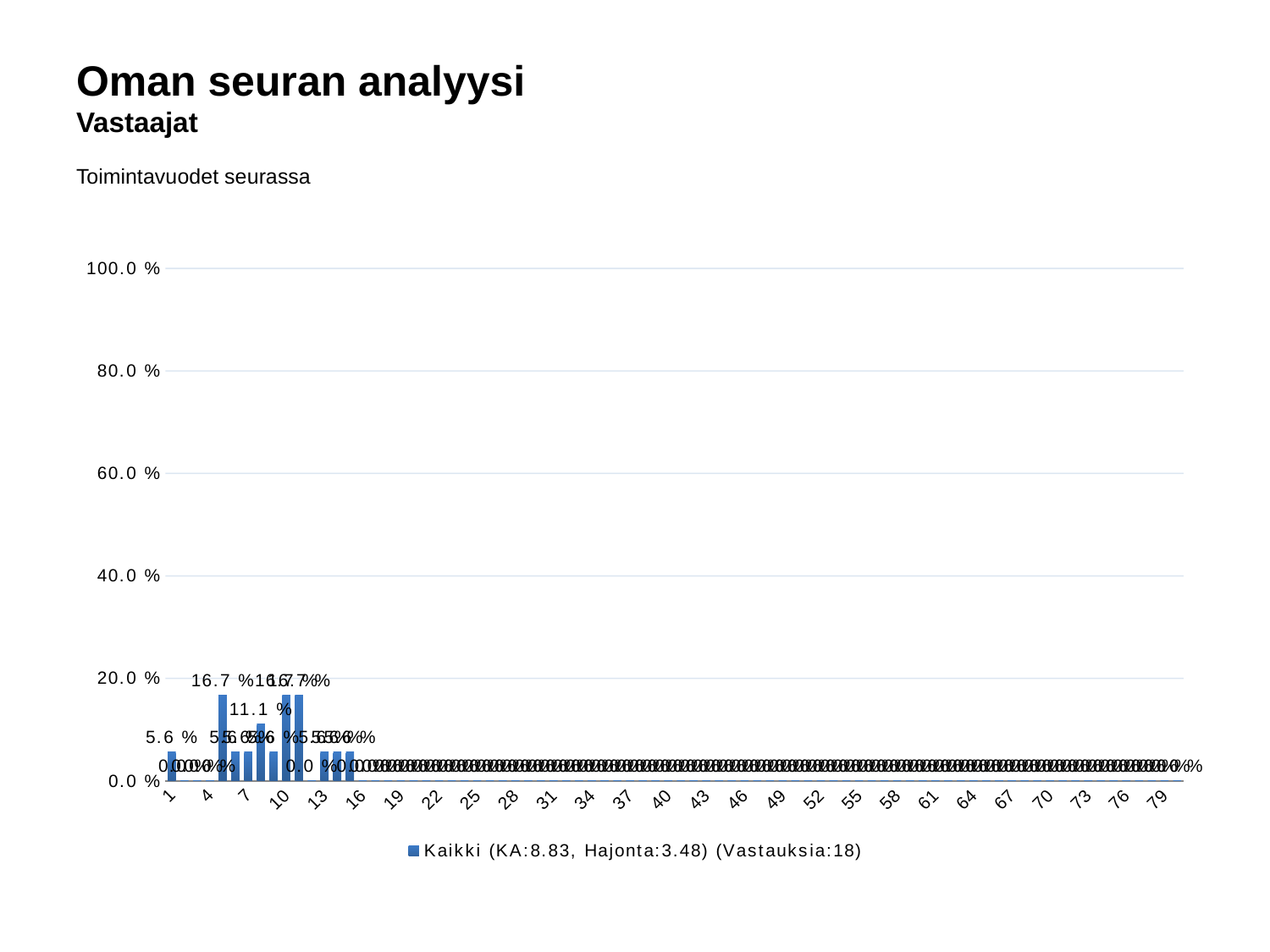
What kind of chart is shown on the slide? bar chart What is the value for category 1? 5.6 % How many series does the legend list? 1 Is the value for category 5 greater or less than 20.0 %? less What is the subtitle text above the chart? Toimintavuodet seurassa What is the legend entry of the chart? Kaikki (KA:8.83, Hajonta:3.48) (Vastauksia:18) What is the highest tick value on the y axis? 100.0 % Is the value for category 1 greater or less than 20.0 %? less Is the value for category 40 greater or less than 20.0 %? less What is the highest value shown by any bar in the chart? 16.7 % How many responses (Vastauksia) does the legend report? 18 Which is larger, the value for category 1 or the value for category 5? category 5